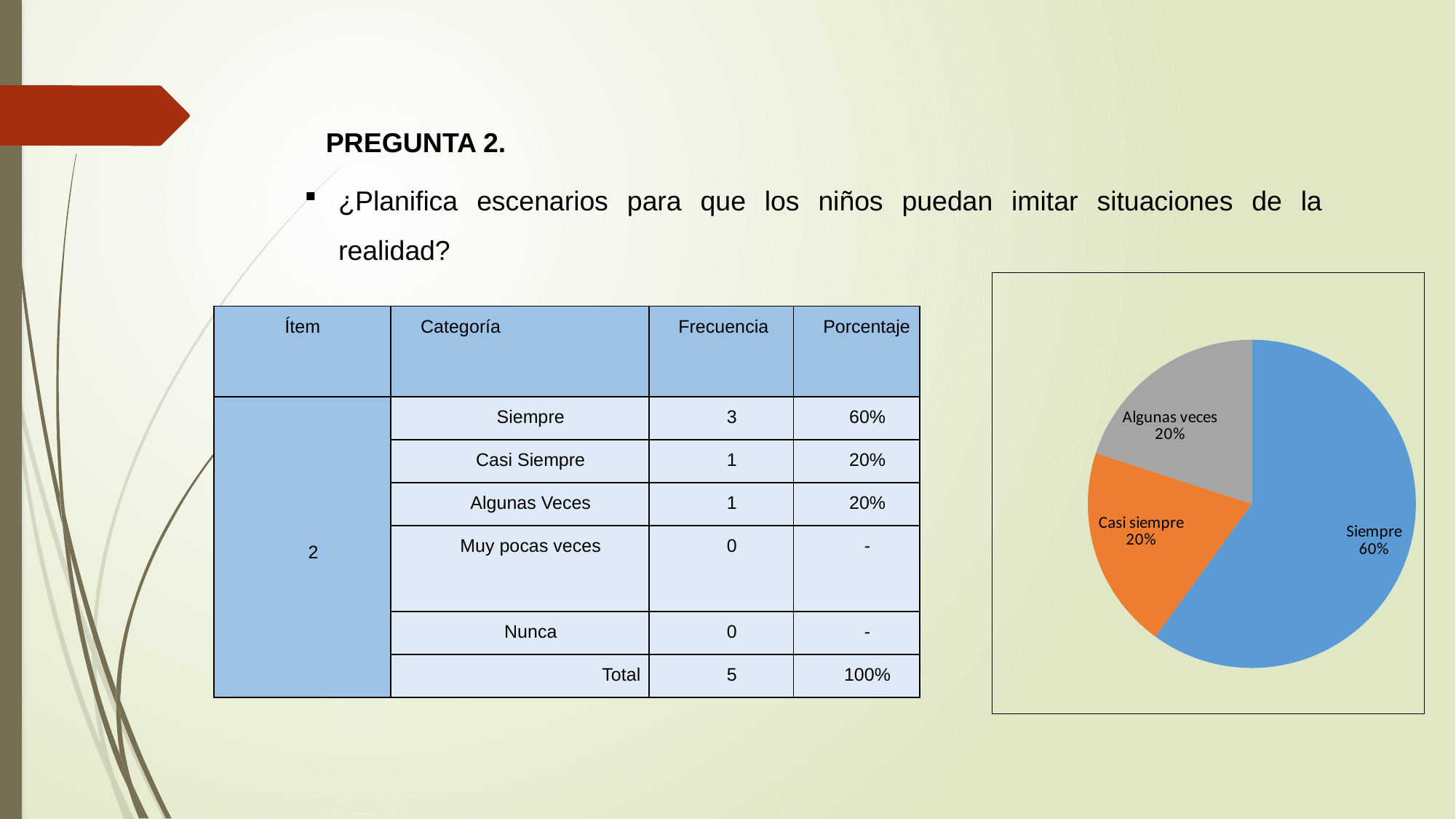
What share of the pie does the Siempre slice represent? 60% Is the share for Siempre greater or less than 50%? greater What share of the pie does the Algunas veces slice represent? 20% Which is larger in the pie chart, Siempre or Algunas veces? Siempre What colour is the Casi siempre slice in the pie chart? orange What share of the pie does the Casi siempre slice represent? 20% What is the difference in percentage points between the Siempre slice and the Casi siempre slice? 40% What colour is the Siempre slice in the pie chart? blue What kind of chart is shown on the slide? pie chart Which slice of the pie chart is the largest? Siempre How many slices does the pie chart have? 3